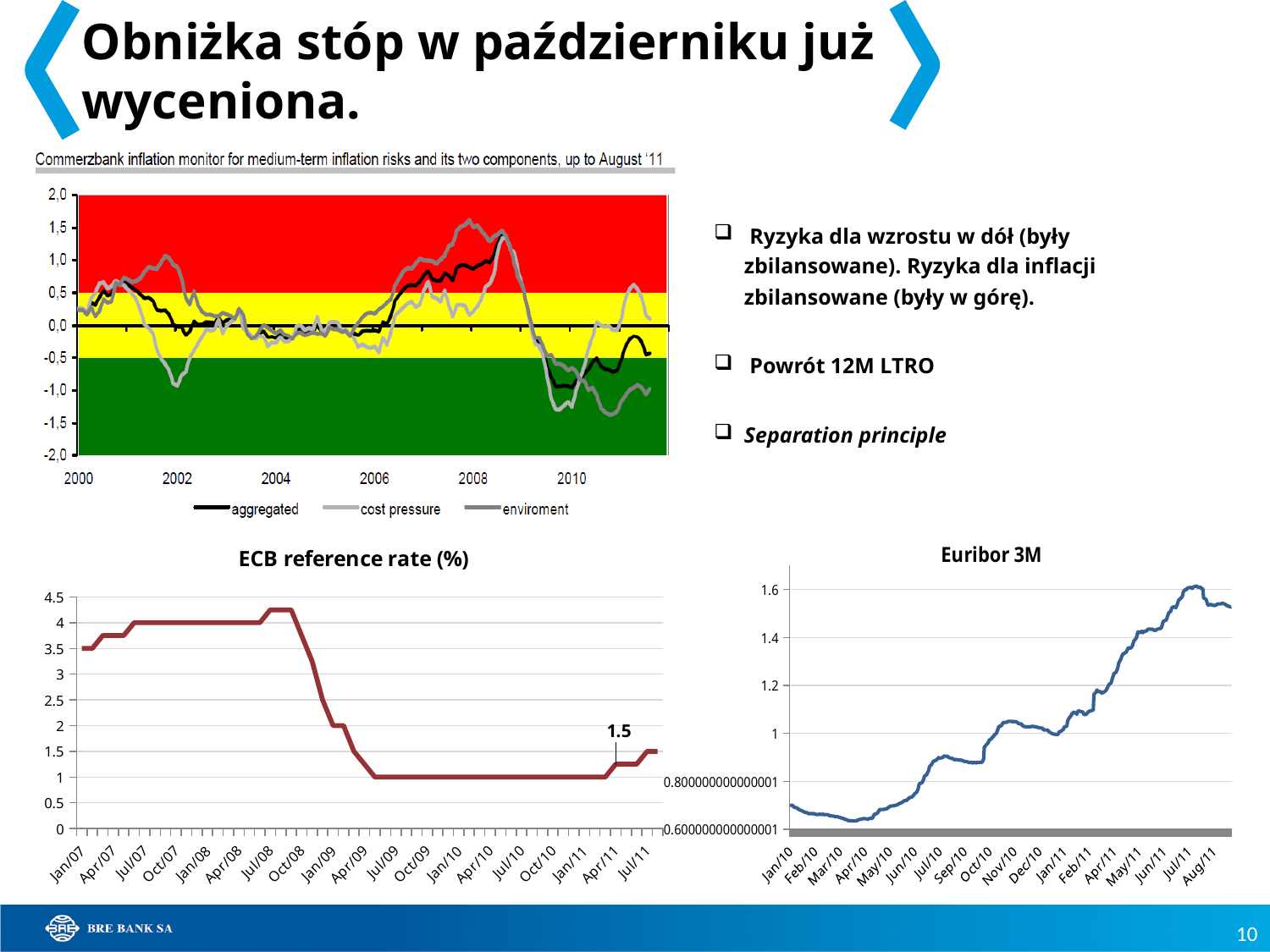
On the 'ECB reference rate (%)' chart, is the value at Jul/09 greater or less than 1.5? less How many series does the legend of the Commerzbank inflation monitor chart (top left) list? 3 On the 'Euribor 3M' chart, is the value at Jul/11 greater or less than 1.4? greater What are the legend entries of the Commerzbank inflation monitor chart (top left)? aggregated, cost pressure, enviroment On the 'ECB reference rate (%)' chart, is the value at Jan/07 greater or less than 3? greater On the 'Euribor 3M' chart, which is larger: the value at Jan/10 or the value at Aug/11? Aug/11 On the 'ECB reference rate (%)' chart, what value is printed as a data label at the end of the line? 1.5 On the 'ECB reference rate (%)' chart, does the rate overall rise or fall from Jan/07 to Jul/11? fall What kind of chart is the 'ECB reference rate (%)' chart? line chart On the 'ECB reference rate (%)' chart, which is larger: the rate at Jan/07 or the rate at Jul/11? Jan/07 On the 'Euribor 3M' chart, does the rate overall rise or fall from Jan/10 to Aug/11? rise